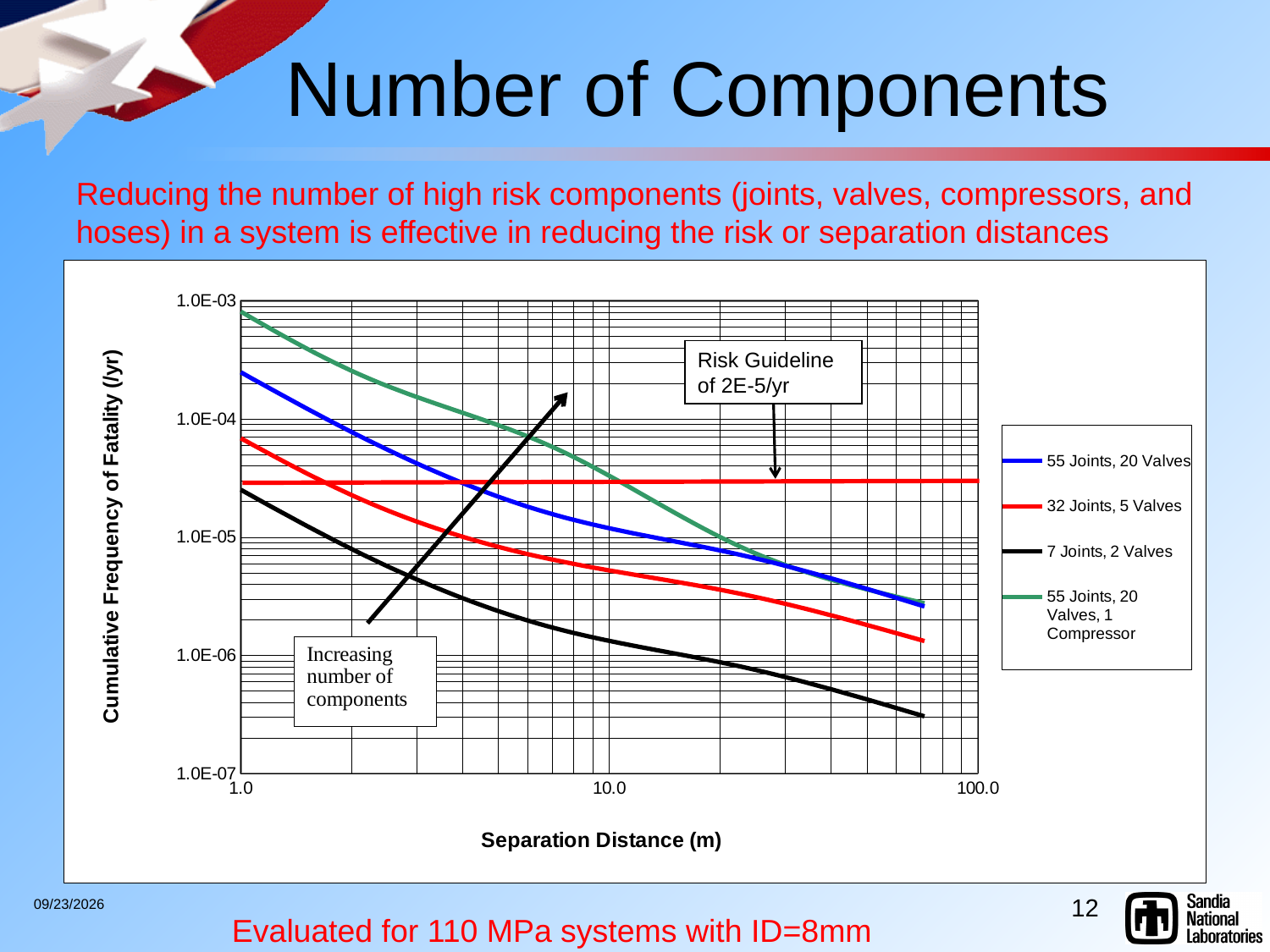
What kind of chart is shown on the slide? Line chart At a separation distance of 1.0 m, which is larger: the value for 32 Joints, 5 Valves or the value for 7 Joints, 2 Valves? 32 Joints, 5 Valves Is the value for 32 Joints, 5 Valves at a separation distance of 10.0 m greater or less than 1.0E-05? less What is the label of the x axis? Separation Distance (m) Is the value for 7 Joints, 2 Valves at a separation distance of 10.0 m greater or less than 1.0E-05? less Do the values for the 7 Joints, 2 Valves series rise or fall as separation distance increases? Fall Is the value for 55 Joints, 20 Valves, 1 Compressor at a separation distance of 1.0 m greater or less than 1.0E-03? less How many series does the chart legend list? 4 Which series has the highest cumulative frequency of fatality at a separation distance of 1.0 m? 55 Joints, 20 Valves, 1 Compressor Which series has the lowest cumulative frequency of fatality at a separation distance of 1.0 m? 7 Joints, 2 Valves What risk guideline value is annotated on the chart? 2E-5/yr